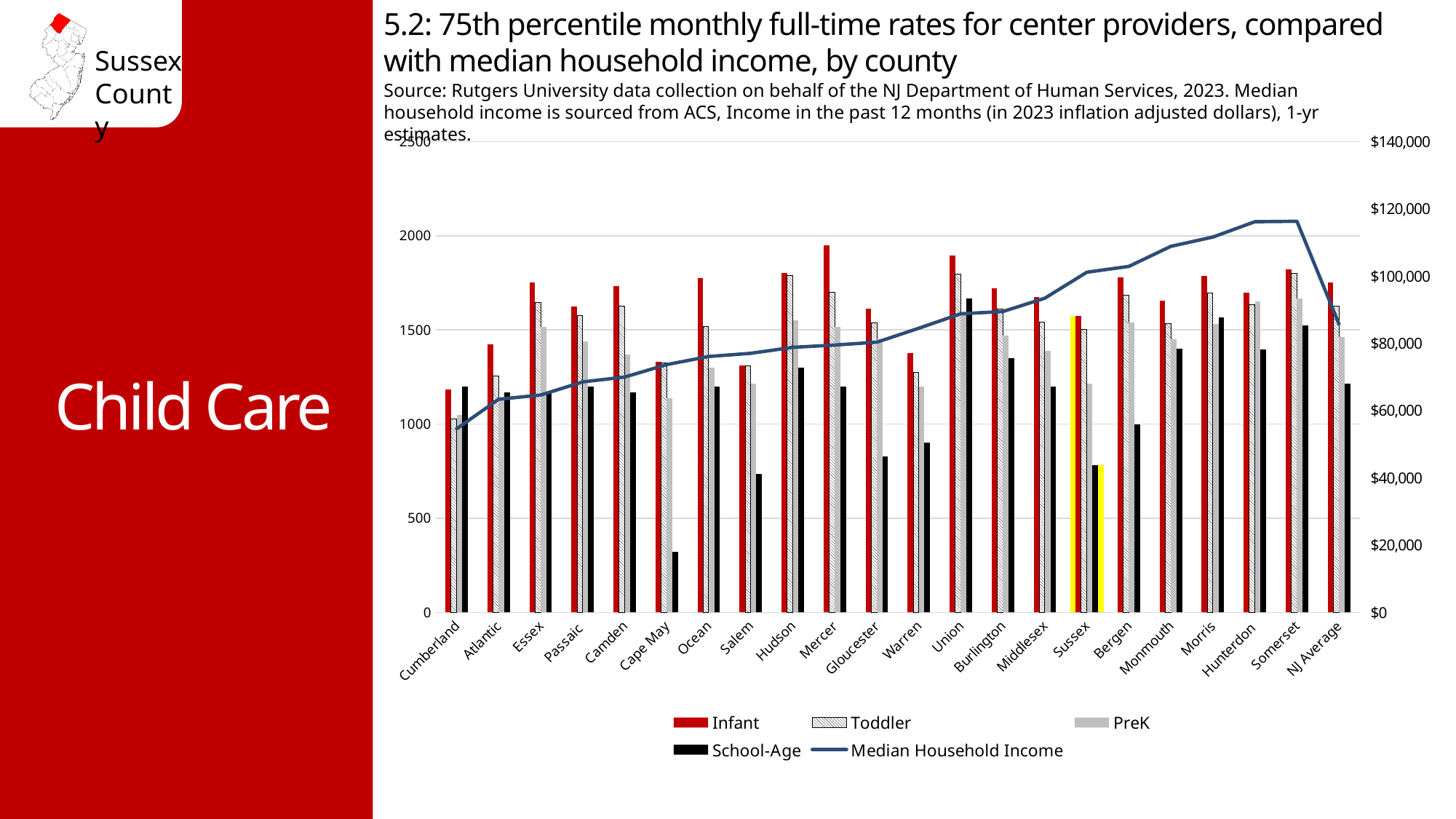
Is the Infant rate for Mercer greater or less than 1500? greater How many counties or categories are shown on the x axis of the chart? 22 How many series does the chart's legend list? 5 Which county has the lowest Infant rate? Cumberland Which is larger, the School-Age rate for Union or for Warren? Union Which county has the lowest School-Age rate? Cape May Which county has the highest Infant rate? Mercer Which county has the lowest Median Household Income? Cumberland Is the Median Household Income for Somerset greater or less than $100,000? greater Does the Median Household Income line generally rise or fall from Cumberland to Somerset? rise Is the School-Age rate for Sussex greater or less than 1000? less What kind of chart is shown on the slide? Bar chart with a line